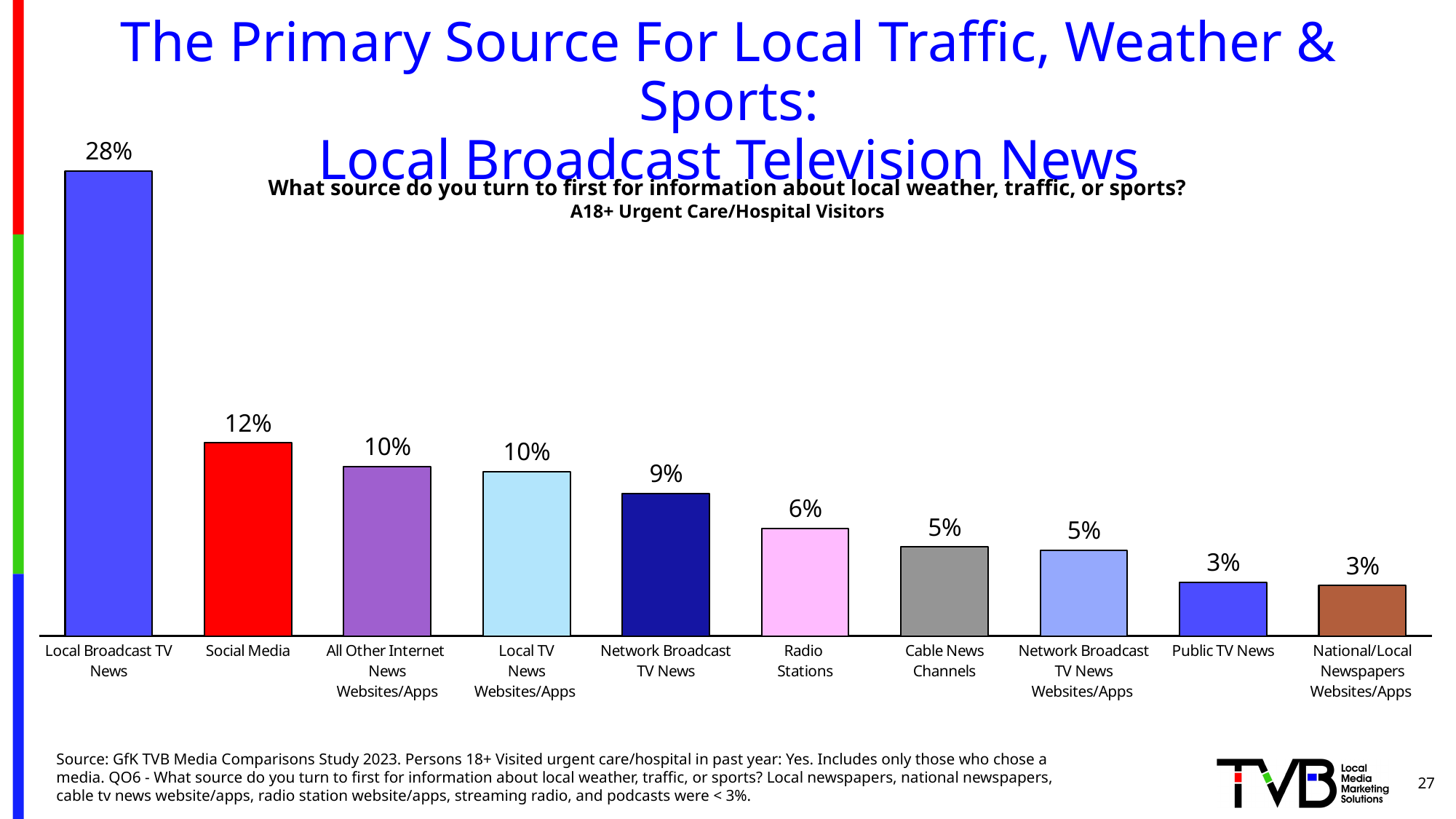
What is the value shown for Social Media? 12% What is the value shown for Radio Stations? 6% How many sources (bars) are shown on the chart? 10 Do the values rise or fall moving from left to right across the chart? Fall What is the lowest value shown on the chart? 3% What kind of chart is shown on the slide? Bar chart Which source has the highest percentage on the chart? Local Broadcast TV News What is the value shown for Network Broadcast TV News? 9% What colour is the bar for Social Media? Red Which is larger, the value for Cable News Channels or the value for Radio Stations? Radio Stations What is the difference between the values for Local Broadcast TV News and Social Media? 16 percentage points What percentage of A18+ urgent care/hospital visitors turn first to Local Broadcast TV News for local weather, traffic, or sports? 28%